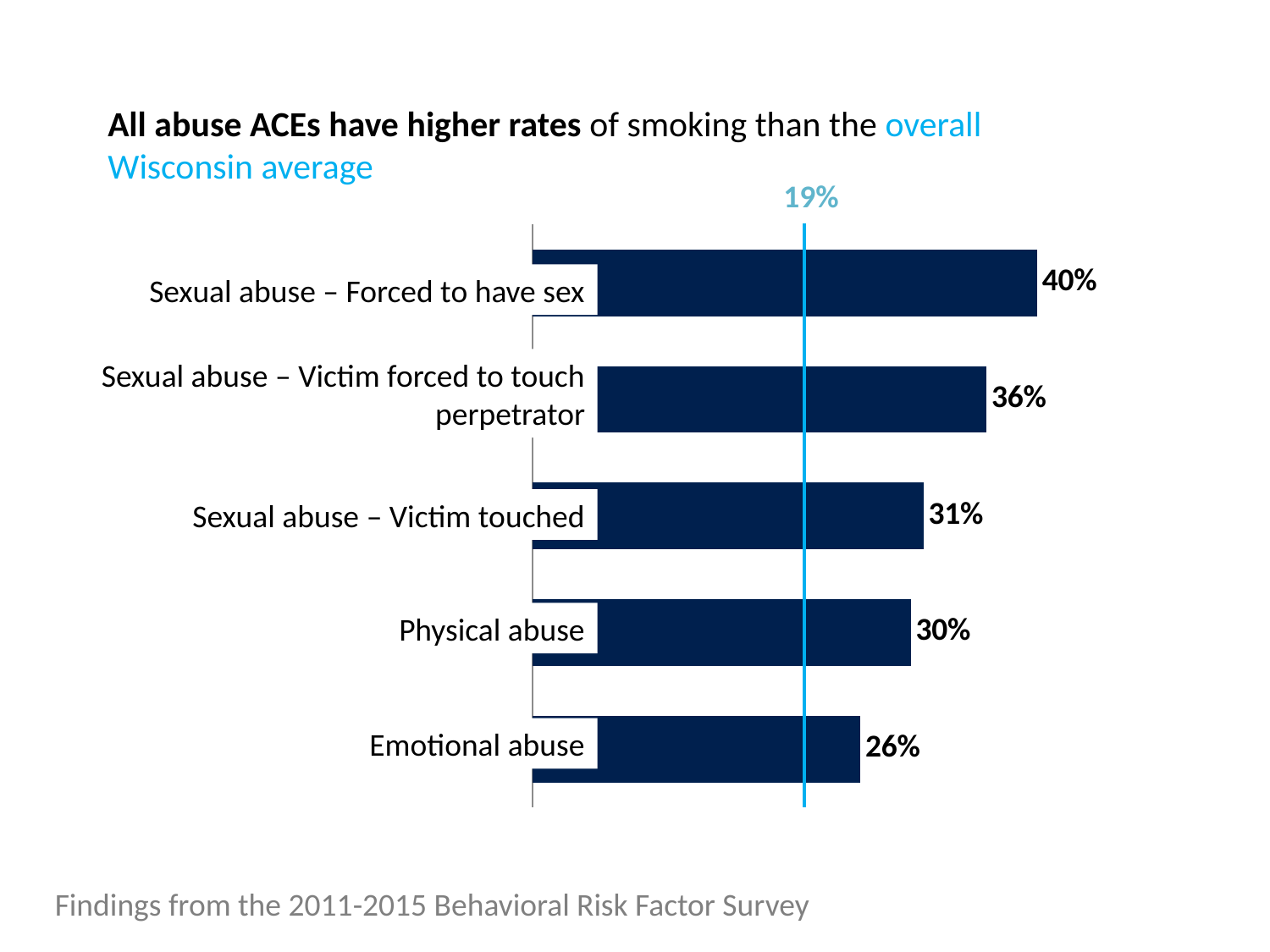
What is the smoking rate for Sexual abuse – Victim forced to touch perpetrator? 36% What is the smoking rate for Emotional abuse? 26% What is the difference between the smoking rates for Sexual abuse – Victim touched and Physical abuse? 1% What kind of chart is shown on the slide? Bar chart Which category has the lowest smoking rate? Emotional abuse Which has a higher smoking rate, Physical abuse or Sexual abuse – Victim forced to touch perpetrator? Sexual abuse – Victim forced to touch perpetrator What is the smoking rate for Physical abuse? 30% Which category has the highest smoking rate? Sexual abuse – Forced to have sex What is the difference between the smoking rates for Sexual abuse – Forced to have sex and Emotional abuse? 14% What value does the vertical blue reference line mark? 19% What is the smoking rate for Sexual abuse – Victim touched? 31% How many categories are shown in the chart? 5